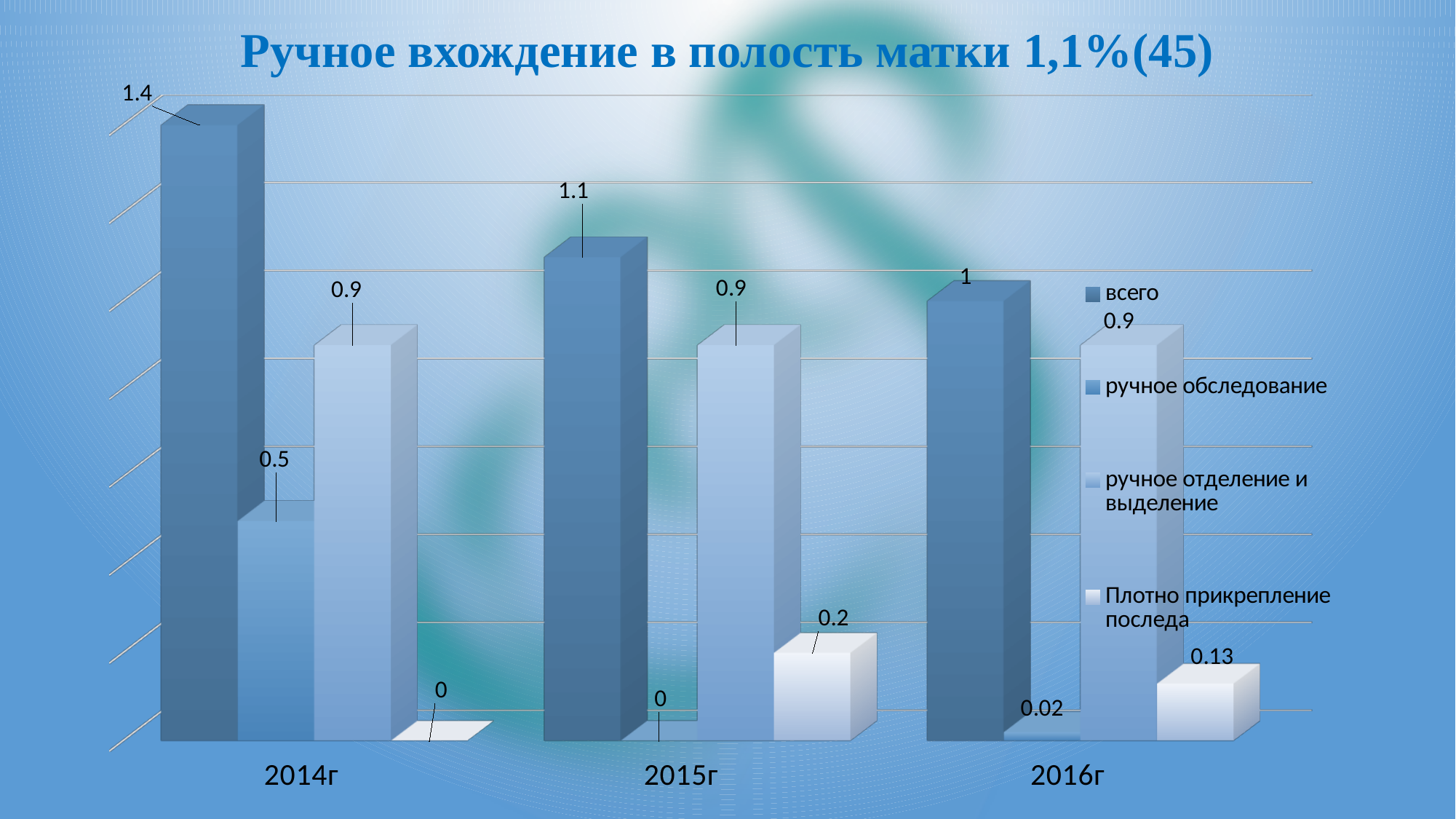
In which year is the "всего" value highest? 2014г How many series does the legend list? 4 In which year is the "всего" value lowest? 2016г What is the value of "ручное обследование" for 2014г? 0.5 What is the value of "Плотно прикрепление последа" for 2015г? 0.2 How many year categories are shown on the x axis? 3 Which is larger: "ручное обследование" in 2014г or "Плотно прикрепление последа" in 2015г? ручное обследование in 2014г Does the "всего" value rise or fall from 2014г to 2016г? fall What is the value of "ручное обследование" for 2016г? 0.02 What is the difference between the "всего" values for 2014г and 2015г? 0.3 What is the value of "всего" for 2014г? 1.4 What is the value of "Плотно прикрепление последа" for 2016г? 0.13